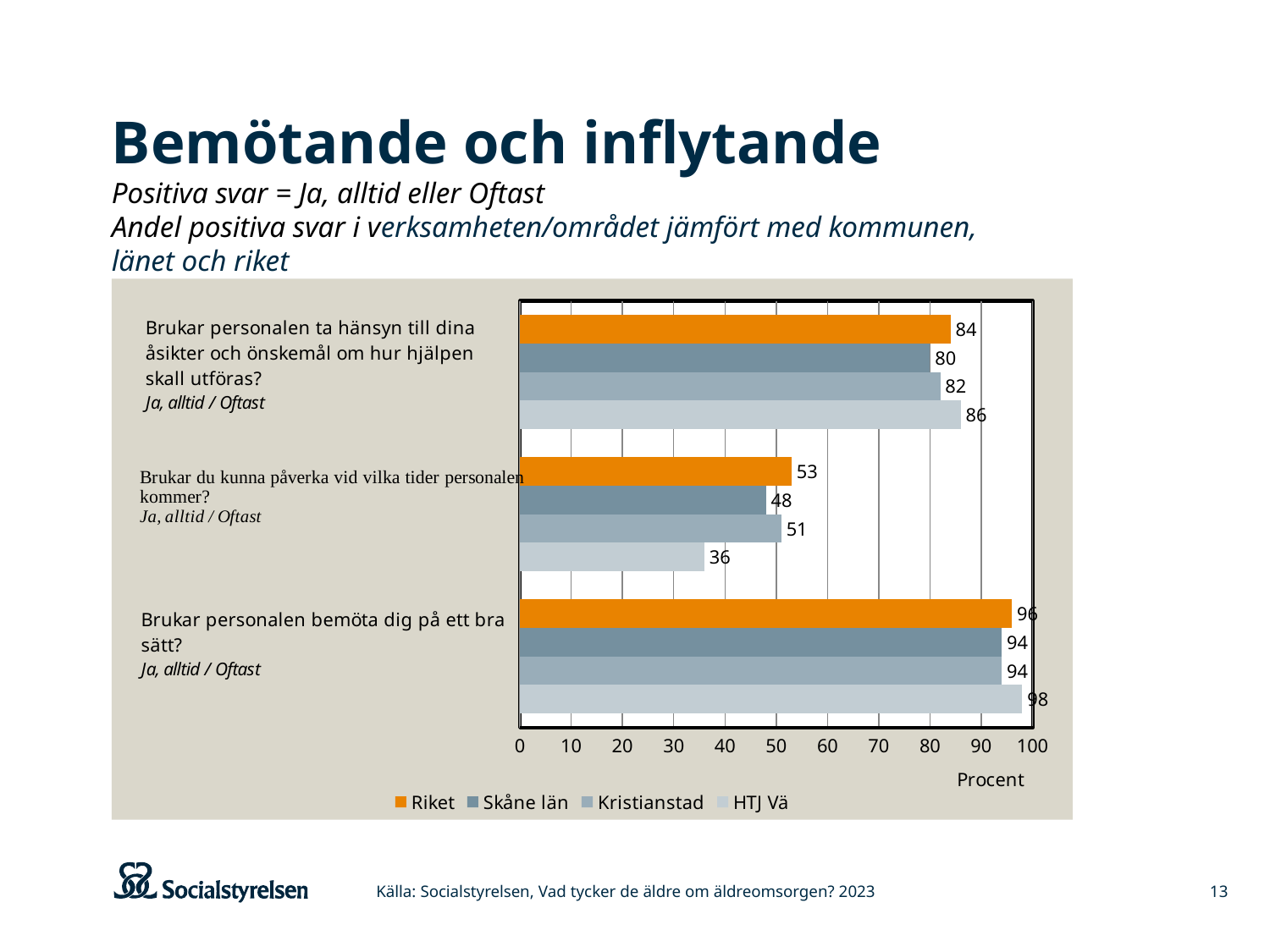
What is the label on the horizontal axis of the chart? Procent What is the difference between the Riket value and the HTJ Vä value on the question "Brukar du kunna påverka vid vilka tider personalen kommer?"? 17 What is the value for Skåne län on the question "Brukar personalen bemöta dig på ett bra sätt?"? 94 What is the value for Riket on the question "Brukar personalen ta hänsyn till dina åsikter och önskemål om hur hjälpen skall utföras?"? 84 What is the value for HTJ Vä on the question "Brukar du kunna påverka vid vilka tider personalen kommer?"? 36 Which series has the highest value on the question "Brukar personalen bemöta dig på ett bra sätt?"? HTJ Vä How many series does the legend list? 4 How many questions (categories) are shown in the chart? 3 Which series has the lowest value on the question "Brukar du kunna påverka vid vilka tider personalen kommer?"? HTJ Vä Is the value for Kristianstad on the question "Brukar du kunna påverka vid vilka tider personalen kommer?" greater or less than 60? less What kind of chart is shown on the slide? bar chart On the question "Brukar personalen ta hänsyn till dina åsikter och önskemål om hur hjälpen skall utföras?", which is larger: the value for Skåne län or the value for Kristianstad? Kristianstad